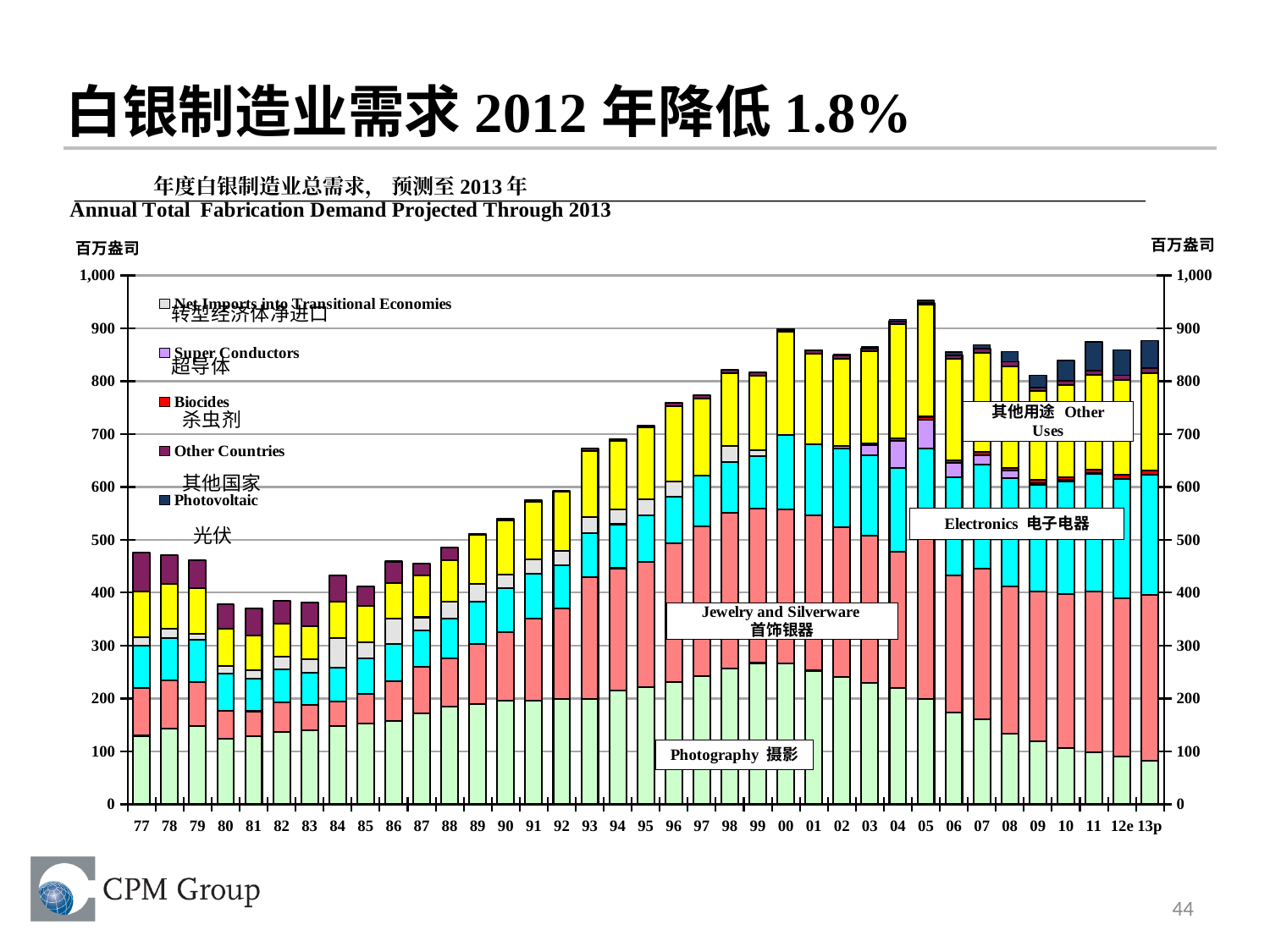
Which year has the tallest total bar on the chart? 05 What kind of chart is shown on the slide? stacked bar chart What is the English title of the chart? Annual Total Fabrication Demand Projected Through 2013 Do the total bars generally rise or fall from 85 to 05? rise Is the total bar for 05 greater or less than 900? greater Which total bar is taller, 05 or 81? 05 Which segment is labelled at the bottom of the stacked bars? Photography 摄影 Is the total bar for 00 greater or less than 800? greater How many years (bars) are plotted on the chart, from 77 through 13p? 37 Is the total bar for 77 greater or less than 500? less Which total bar is taller, 93 or 86? 93